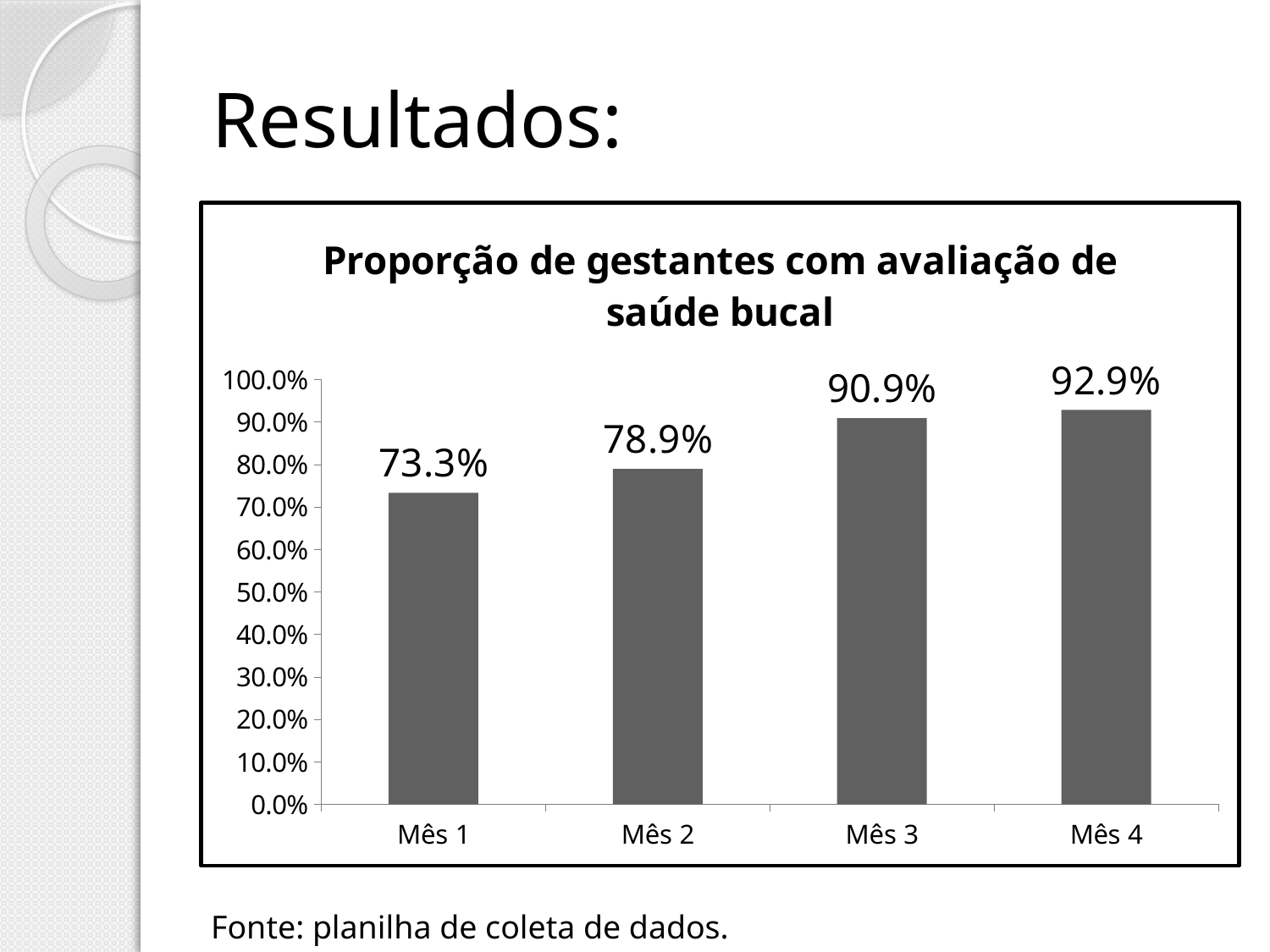
What is the difference between the values for Mês 2 and Mês 1? 5.6% Which month has the highest proportion? Mês 4 What is the value for Mês 3? 90.9% How many months are shown on the x axis? 4 What is the difference between the values for Mês 4 and Mês 3? 2.0% What is the value for Mês 1? 73.3% What is the value for Mês 4? 92.9% What kind of chart is shown? bar chart Which month has the lowest proportion? Mês 1 Is the value for Mês 2 greater or less than 80.0%? less Do the values rise or fall from Mês 1 to Mês 4? rise Which is larger, the value for Mês 2 or the value for Mês 3? Mês 3